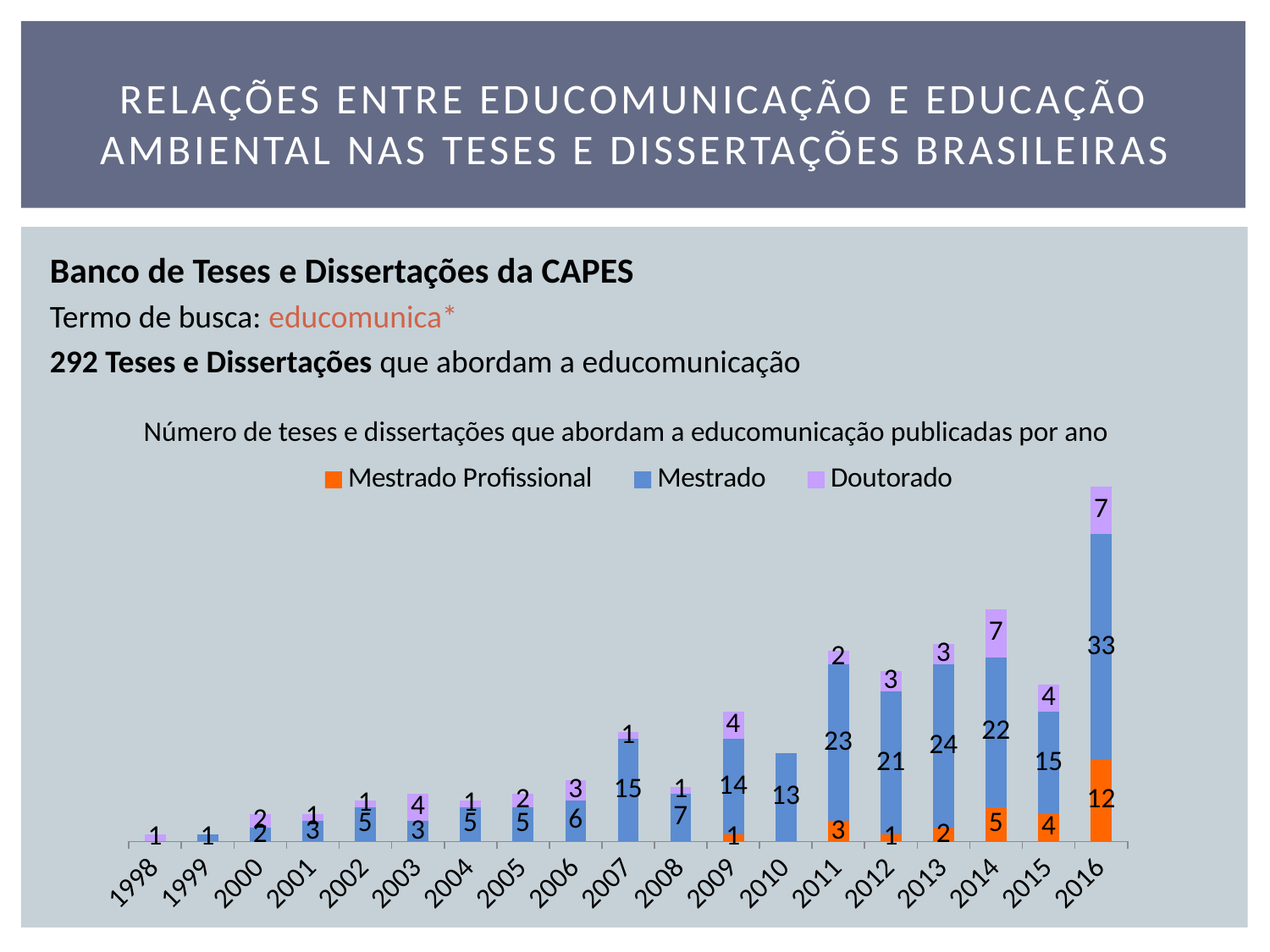
What is the total of the stacked bar for 2014? 34 What is the Doutorado value for 2003? 4 What is the title of the chart? Número de teses e dissertações que abordam a educomunicação publicadas por ano What is the difference between the Mestrado values for 2013 and 2012? 3 What is the Mestrado value for 2016? 33 How many series does the legend list? 3 Which is larger, the Mestrado value for 2007 or for 2010? 2007 Which year has the highest total number of theses and dissertations? 2016 What is the Mestrado Profissional value for 2014? 5 What is the total of the stacked bar for 2016? 52 How many years are shown on the x axis? 19 What kind of chart is shown on the slide? Stacked bar chart